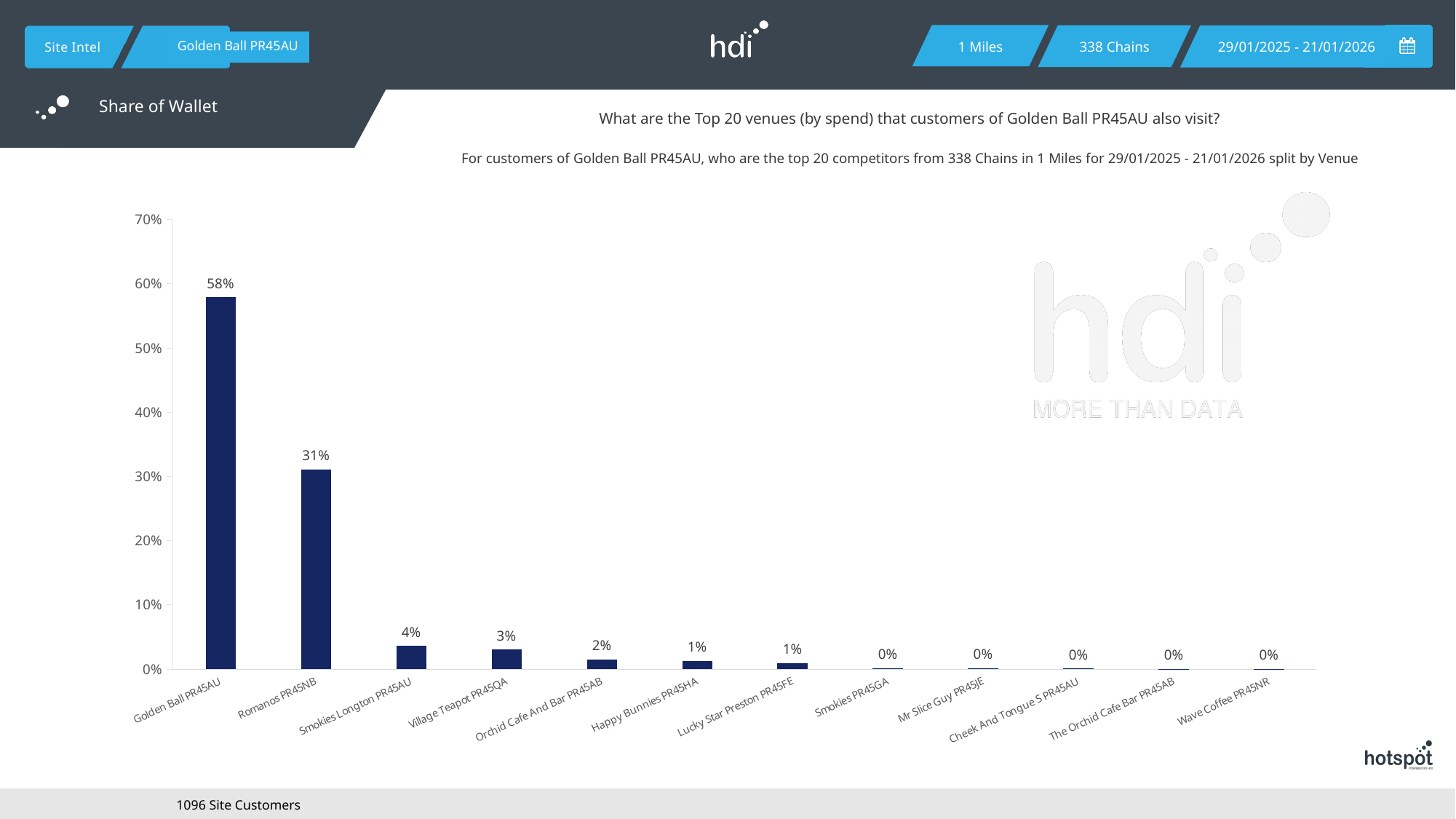
What is the difference between the values for Golden Ball PR45AU and Romanos PR45NB? 27% Which is larger, the value for Romanos PR45NB or the value for Smokies Longton PR45AU? Romanos PR45NB What is the value for Romanos PR45NB? 31% Is the value for Golden Ball PR45AU greater or less than 50%? greater How many venues are shown on the x axis? 12 Which venue has the highest value? Golden Ball PR45AU What is the difference between the values for Smokies Longton PR45AU and Village Teapot PR45QA? 1% What is the value for Smokies Longton PR45AU? 4% What kind of chart is shown on the slide? bar chart Do the values rise or fall from left to right along the x axis? fall What is the value for Golden Ball PR45AU? 58% What is the value for Orchid Cafe And Bar PR45AB? 2%